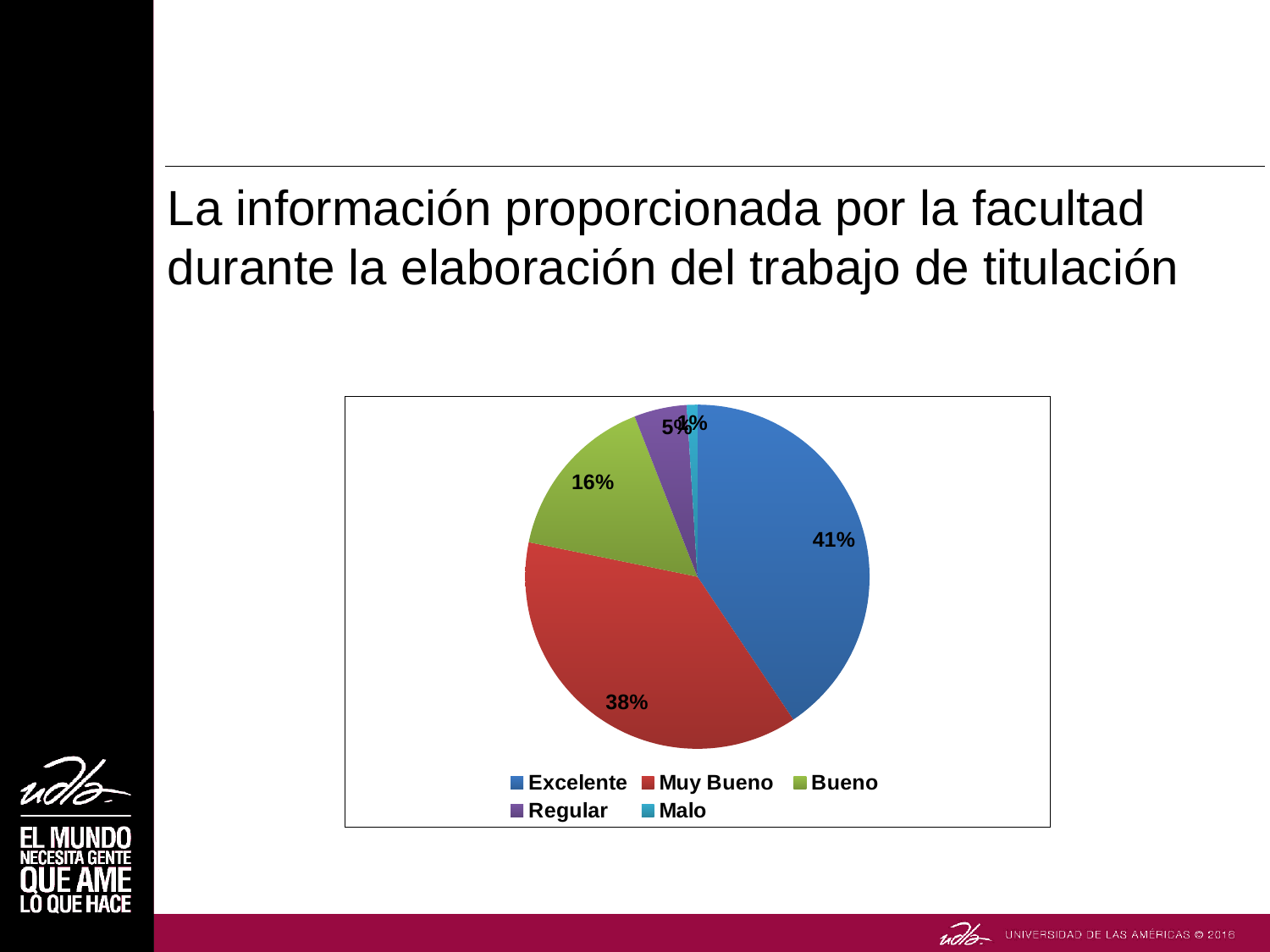
What percentage of the pie corresponds to Bueno? 16% What is the difference in percentage points between Excelente and Muy Bueno? 3 percentage points Which has a larger share, Bueno or Regular? Bueno Which category has the smallest share of the pie? Malo What percentage of the pie corresponds to Regular? 5% What colour is the Excelente slice? Blue What percentage of the pie corresponds to Muy Bueno? 38% What is the difference in percentage points between Muy Bueno and Bueno? 22 percentage points Which category has the largest share of the pie? Excelente What type of chart is shown on the slide? Pie chart How many categories does the legend list? 5 What percentage of the pie corresponds to Excelente? 41%